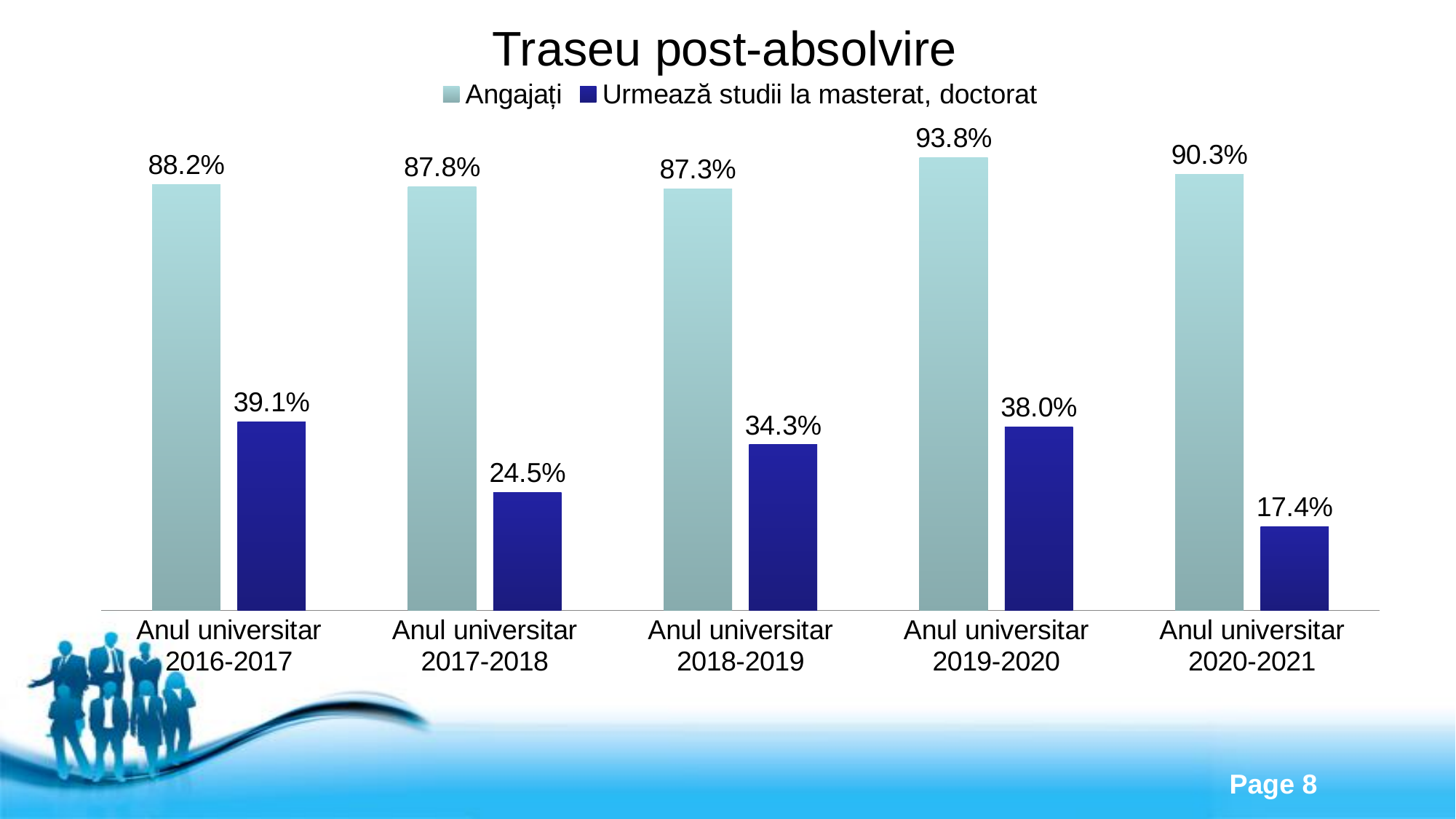
How many series does the legend list? 2 Which academic year has the highest value for Angajați? Anul universitar 2019-2020 What kind of chart is shown on the slide? Bar chart What is the difference between the Angajați values for Anul universitar 2019-2020 and Anul universitar 2018-2019? 6.5% Which academic year has the lowest value for Urmează studii la masterat, doctorat? Anul universitar 2020-2021 What is the title of the chart? Traseu post-absolvire What is the value for Angajați in Anul universitar 2019-2020? 93.8% How many academic years are shown on the x axis? 5 What is the value for Urmează studii la masterat, doctorat in Anul universitar 2017-2018? 24.5% What is the value for Angajați in Anul universitar 2016-2017? 88.2% Which is larger: the Urmează studii la masterat, doctorat value in Anul universitar 2016-2017 or in Anul universitar 2018-2019? Anul universitar 2016-2017 What is the difference between the Angajați value and the Urmează studii la masterat, doctorat value in Anul universitar 2020-2021? 72.9%